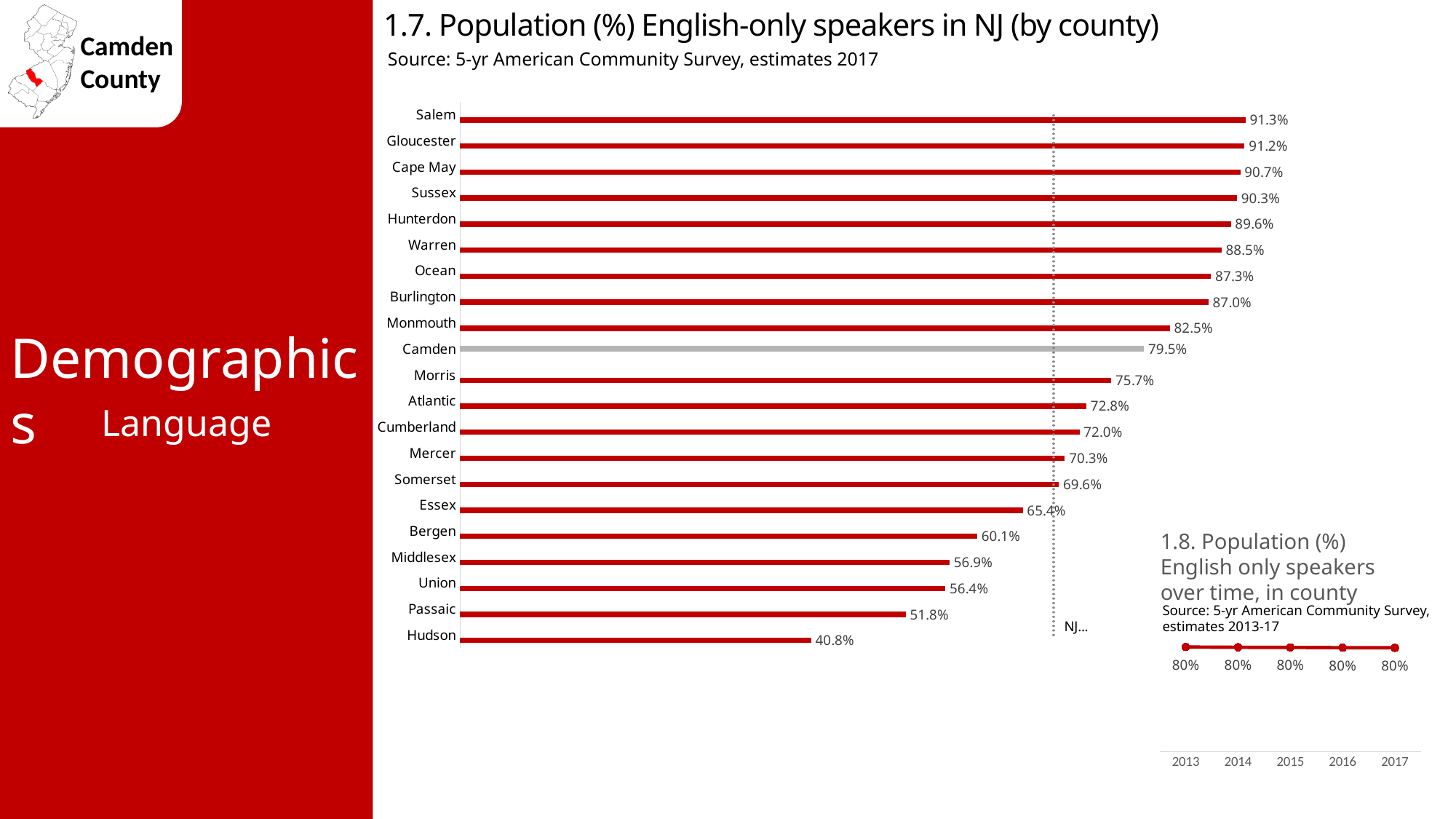
In chart 1.8, how many data points are plotted? 5 In chart 1.7, what is the difference between the values for Salem and Hudson? 50.5% In chart 1.7, which county has the highest value? Salem In chart 1.7, which is larger, the value for Morris or the value for Essex? Morris In chart 1.7, what is the value for Hudson? 40.8% In chart 1.7, what is the value for Bergen? 60.1% In chart 1.7, what is the value for Camden? 79.5% What kind of chart is chart 1.7? Bar chart In chart 1.7, how many counties are shown? 21 In chart 1.7, which county has the lowest value? Hudson In chart 1.8, do the values rise, fall or stay flat from 2013 to 2017? Stay flat In chart 1.8, what is the value for 2017? 80%